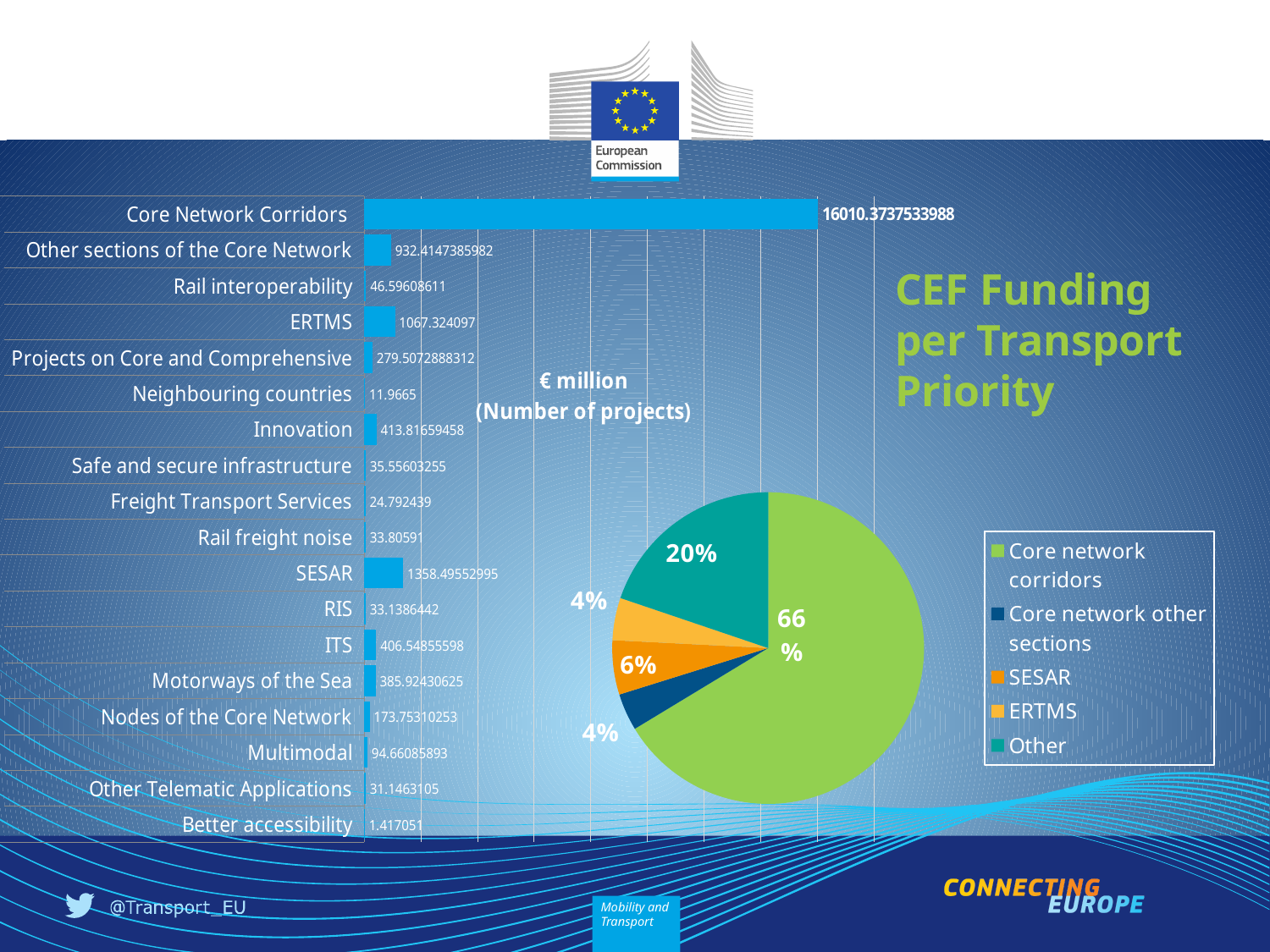
In the bar chart, which category has the lowest value? Better accessibility In the bar chart, what is the value for Motorways of the Sea? 385.92430625 What kind of chart is the chart on the left side of the slide? Bar chart In the bar chart, which is larger: ERTMS or Innovation? ERTMS In the bar chart, what is the value for SESAR? 1358.49552995 In the bar chart, what is the value for Core Network Corridors? 16010.3737533988 In the bar chart, which category has the highest value? Core Network Corridors In the pie chart, what share does Core network corridors have? 66% In the pie chart, what share does the Other slice have? 20% How many categories does the bar chart show? 18 In the bar chart, what is the value for Neighbouring countries? 11.9665 How many entries does the pie chart legend list? 5